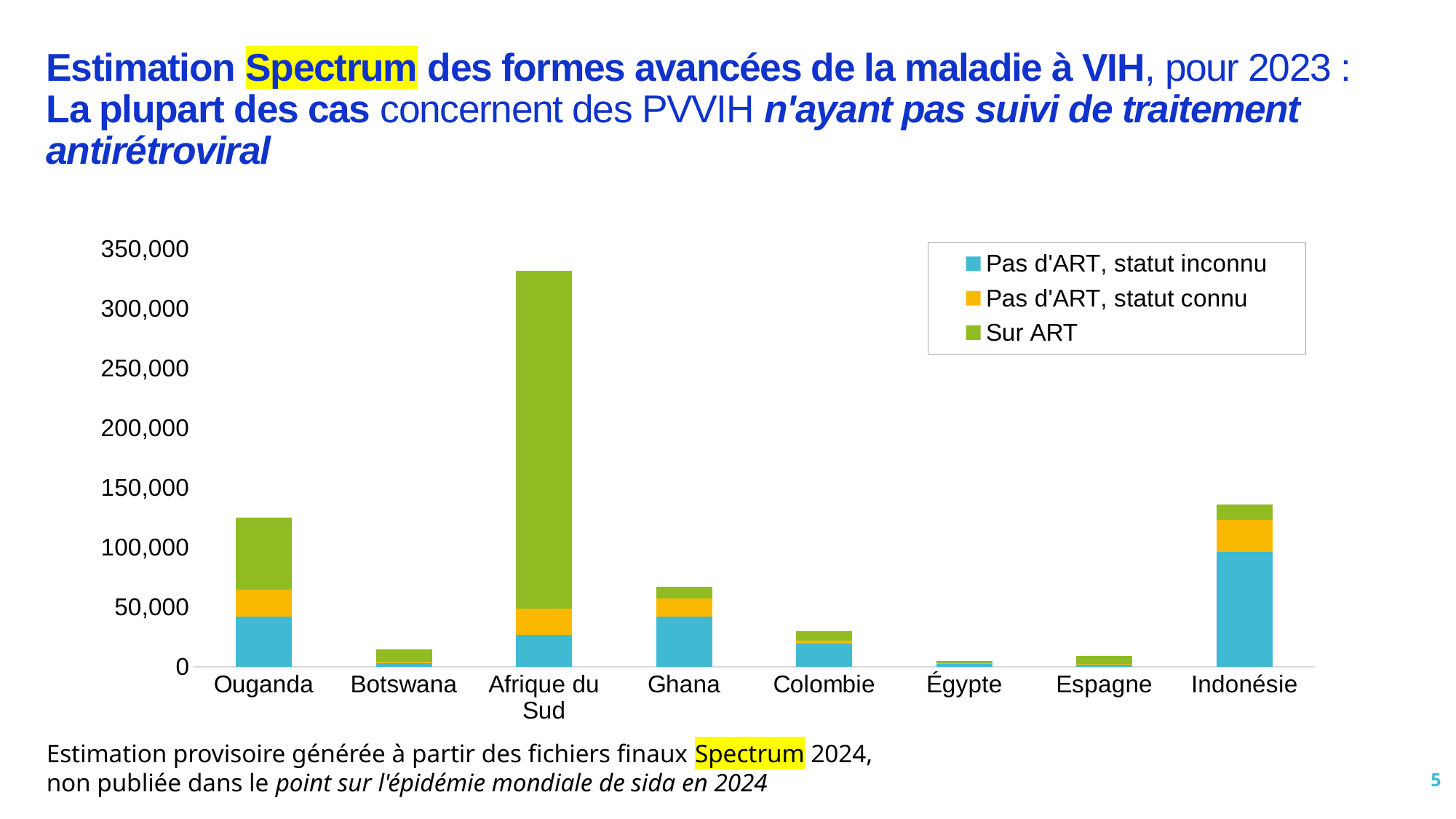
How many countries are shown on the x axis of the chart? 8 Which has the larger total bar, Ouganda or Ghana? Ouganda Is the total value for Afrique du Sud greater or less than 300,000? greater Is the total value for Ghana greater or less than 100,000? less Which country has the highest total bar in the chart? Afrique du Sud Which colour represents the 'Sur ART' series in the legend? Green Which country has the largest 'Sur ART' (green) segment? Afrique du Sud How many series does the chart legend list? 3 Which country has the largest 'Pas d'ART, statut inconnu' (blue) segment? Indonésie Is the total value for Botswana greater or less than 50,000? less What kind of chart is shown on the slide? Stacked bar chart